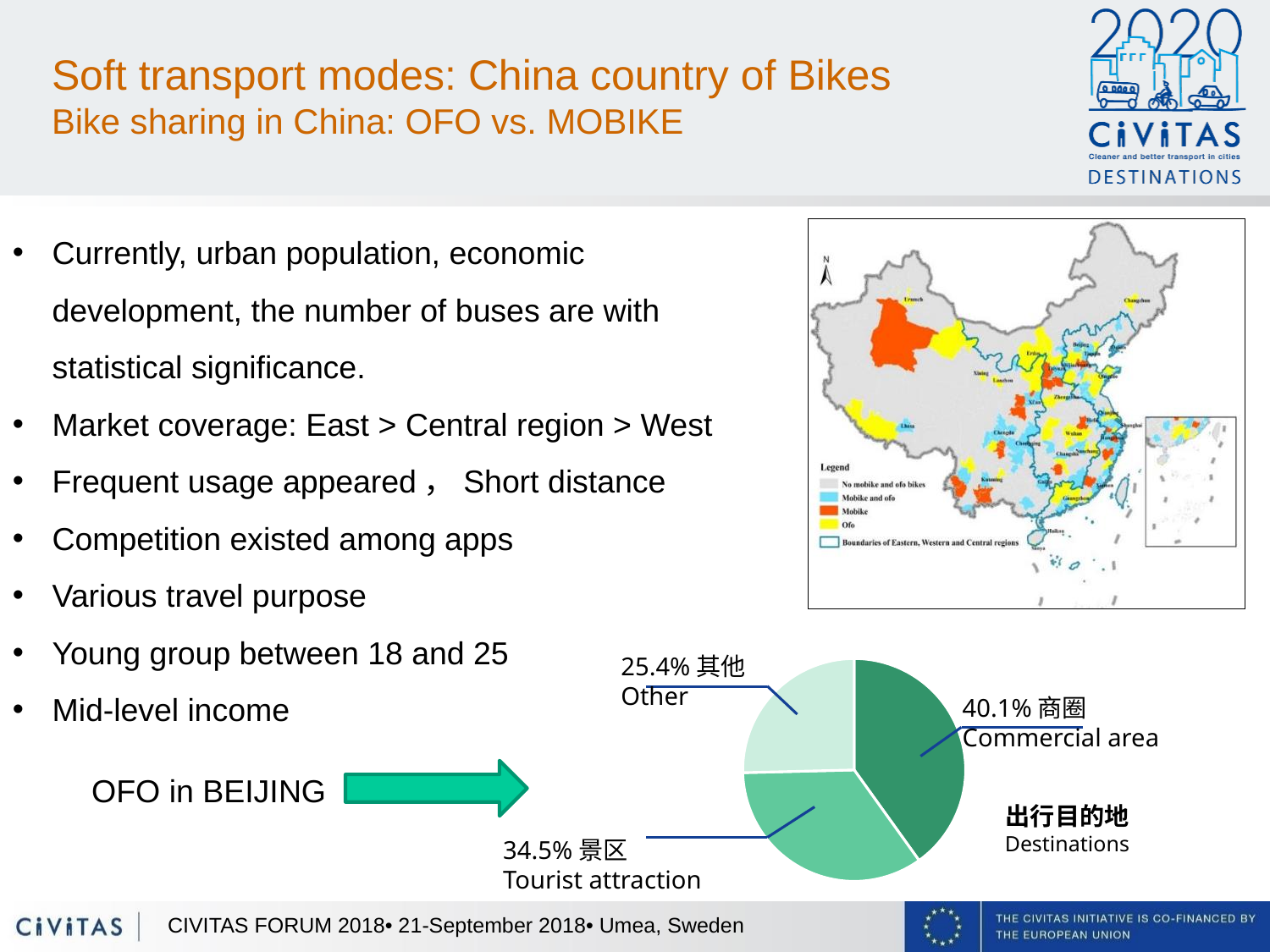
Which slice of the Destinations pie chart is the smallest? Other Which city does the Destinations pie chart refer to, according to the label next to the arrow? Beijing What share of the Destinations pie chart is Tourist attraction? 34.5% How many slices does the Destinations pie chart have? 3 In the Destinations pie chart, which is larger: Tourist attraction or Other? Tourist attraction In the Destinations pie chart, what is the difference between the Commercial area share and the Tourist attraction share? 5.6% In the Destinations pie chart, what is the difference between the Tourist attraction share and the Other share? 9.1% What share of the Destinations pie chart is Other? 25.4% Is the Commercial area share in the Destinations pie chart greater or less than 50%? less What kind of chart is used to show Destinations on the slide? Pie chart What share of the Destinations pie chart is Commercial area? 40.1% Which slice of the Destinations pie chart is the largest? Commercial area